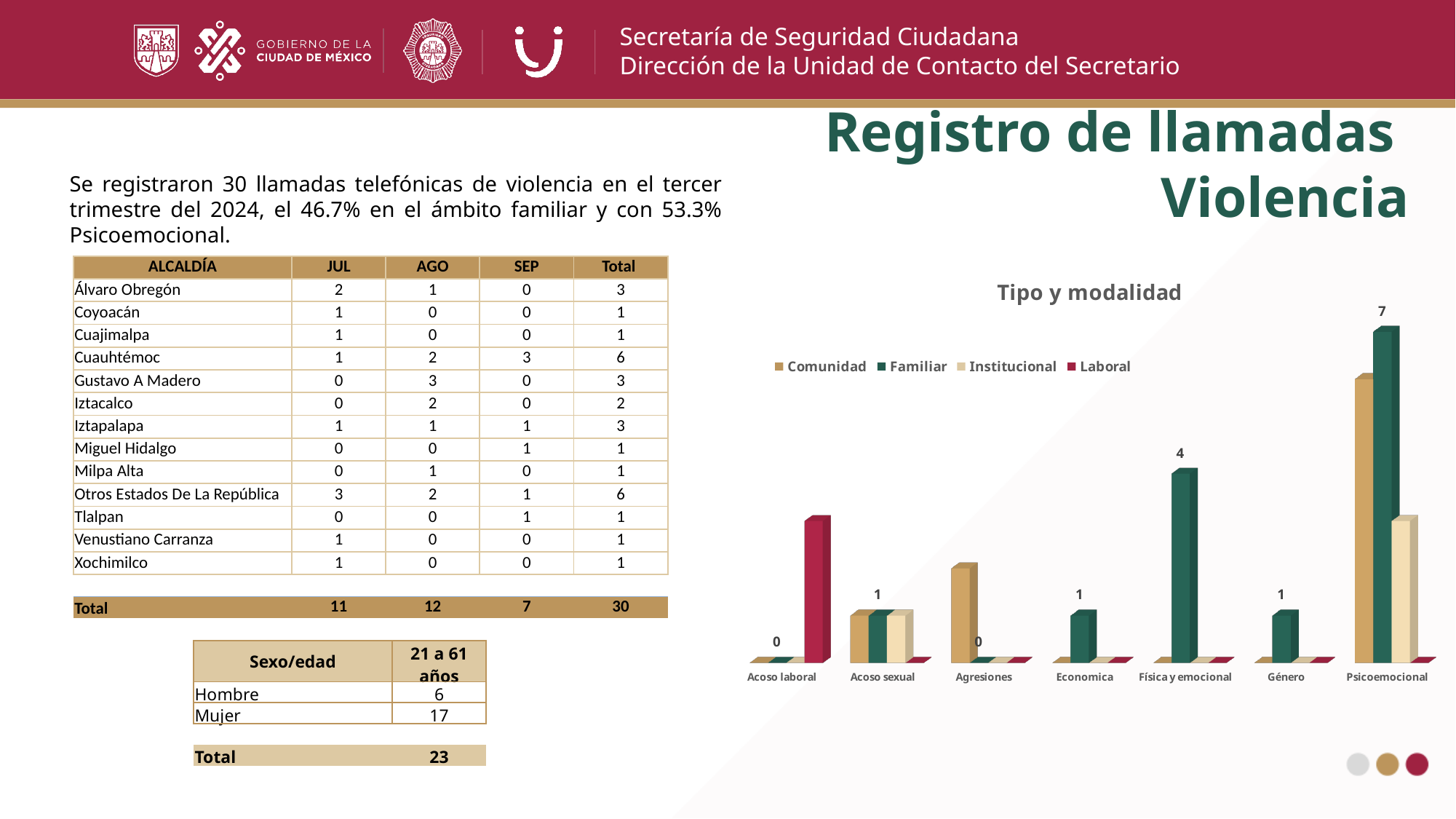
How many series does the legend of the 'Tipo y modalidad' chart list? 4 In the 'Tipo y modalidad' chart, what is the Familiar value for Economica? 1 In the 'Tipo y modalidad' chart, what is the Familiar value for Género? 1 In the 'Tipo y modalidad' chart, which is larger for Psicoemocional: the Familiar bar or the Institucional bar? Familiar What are the legend entries of the 'Tipo y modalidad' chart? Comunidad, Familiar, Institucional, Laboral In the 'Tipo y modalidad' chart, which category has the highest Familiar value? Psicoemocional In the 'Tipo y modalidad' chart, what is the Familiar value for Psicoemocional? 7 In the 'Tipo y modalidad' chart, what is the Familiar value for Física y emocional? 4 What type of chart is 'Tipo y modalidad'? bar chart In the 'Tipo y modalidad' chart, what is the difference between the Familiar values for Psicoemocional and Física y emocional? 3 In the 'Tipo y modalidad' chart, which is larger for Acoso laboral: the Laboral bar or the Familiar bar? Laboral How many categories are shown on the x axis of the 'Tipo y modalidad' chart? 7